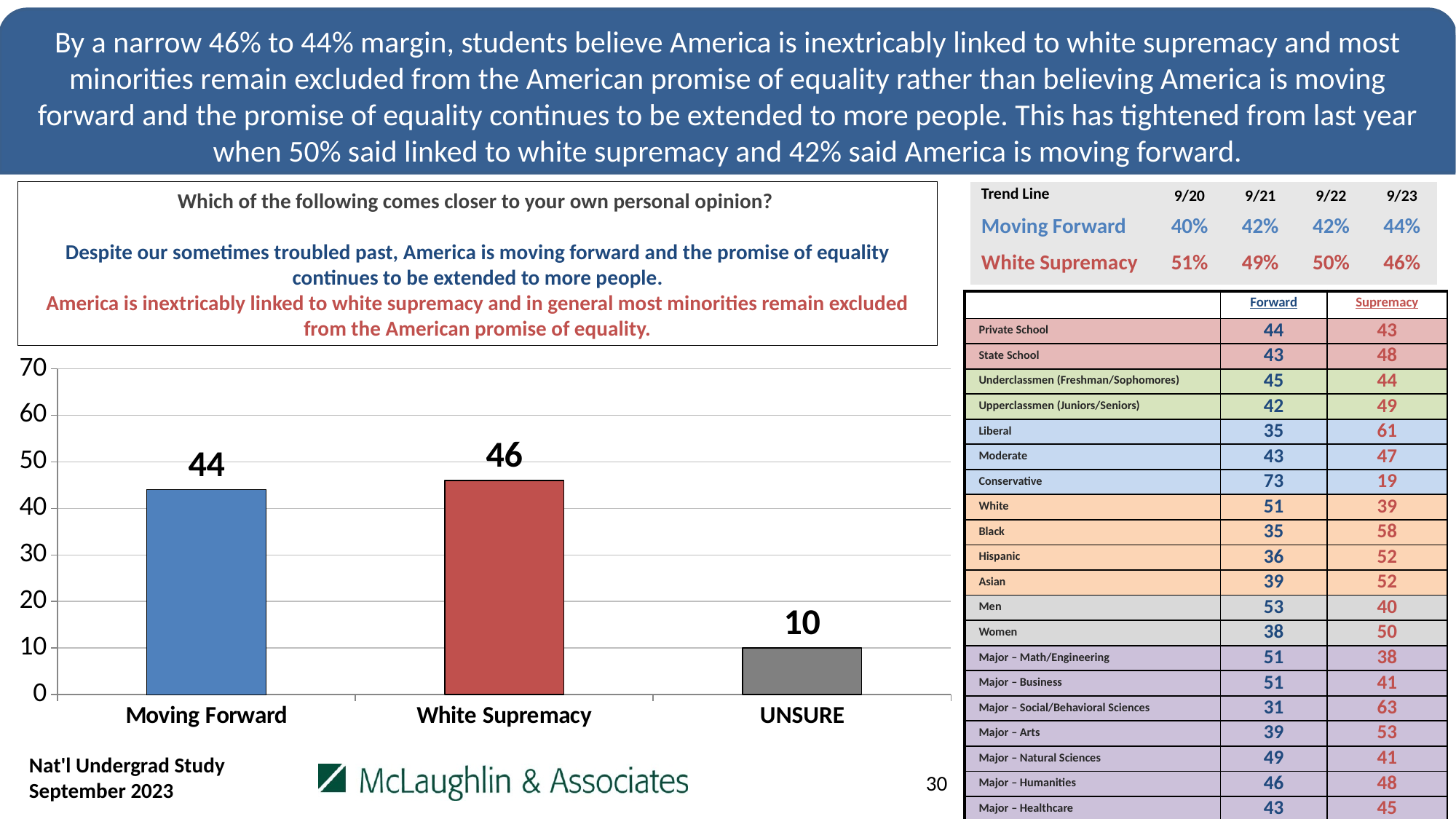
What is the highest value shown on the vertical axis of the bar chart? 70 What kind of chart is shown on the slide? bar chart What is the difference between the Moving Forward and UNSURE bars? 34 What is the difference between the White Supremacy and Moving Forward bars? 2 What is the value of the Moving Forward bar? 44 What is the value of the White Supremacy bar? 46 Which category has the lowest bar? UNSURE Is the value for White Supremacy greater or less than 40? greater How many categories are shown on the bar chart? 3 Which category has the highest bar? White Supremacy What is the value of the UNSURE bar? 10 Which is larger, the Moving Forward bar or the UNSURE bar? Moving Forward